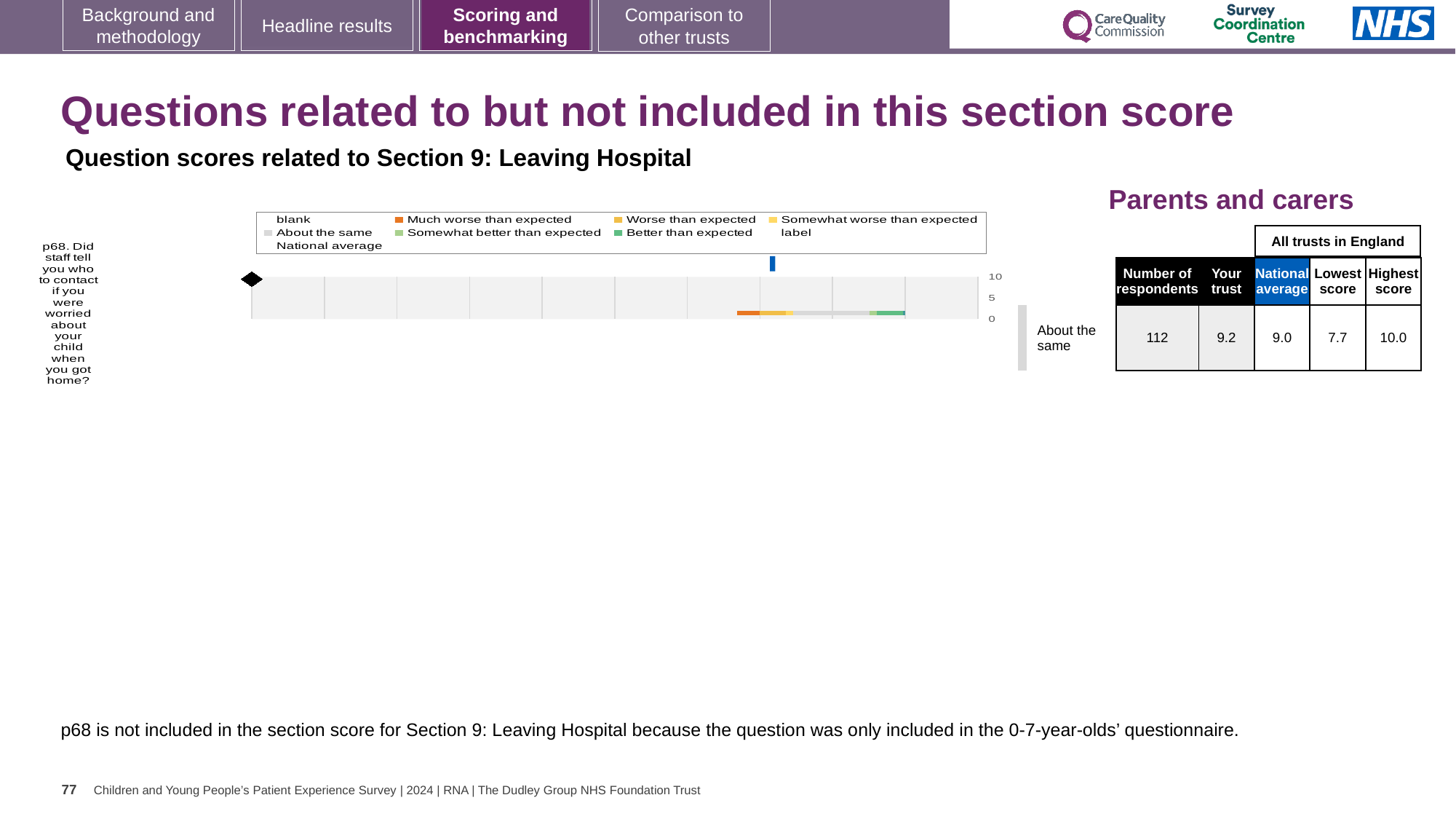
In the table beside the chart, what is the national average score for p68? 9.0 What is the highest tick value shown on the chart's score axis? 10 In the table beside the chart, what is the lowest score among all trusts in England for p68? 7.7 For p68, which is larger: the 'Your trust' score or the national average? Your trust In the table beside the chart, how many respondents answered p68? 112 Which question is plotted in the chart? p68. Did staff tell you who to contact if you were worried about your child when you got home? In the table beside the chart, what is the 'Your trust' score for p68? 9.2 What kind of chart is used to show the p68 question score? bar chart For p68, what is the difference between the highest score and the lowest score among all trusts in England? 2.3 What benchmark category is shown next to the chart for p68? About the same How many questions are plotted in the chart? 1 In the table beside the chart, what is the highest score among all trusts in England for p68? 10.0